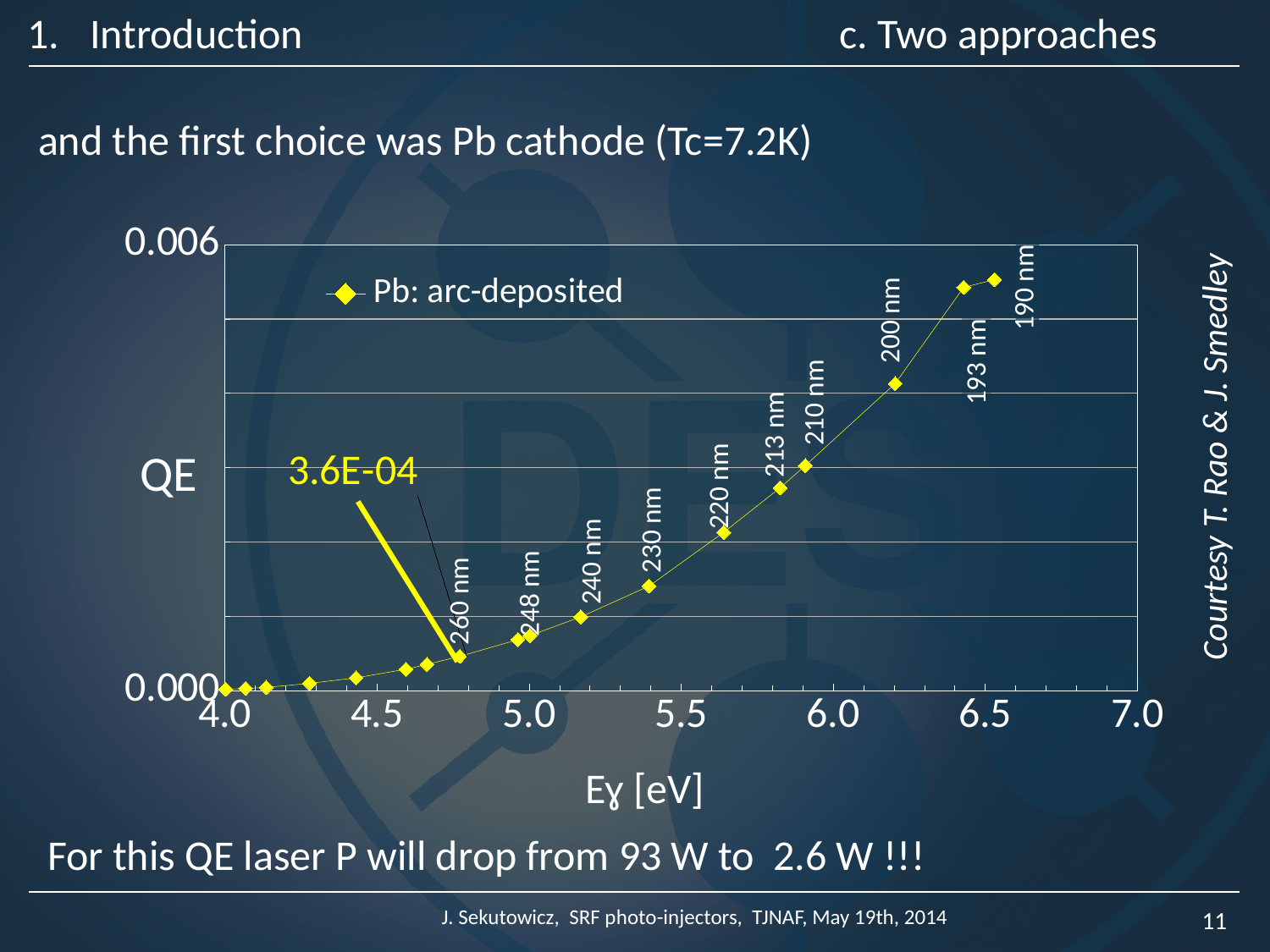
What is the label of the x axis of the chart? Eγ [eV] Which labeled wavelength point has the lowest QE? 260 nm What QE value is annotated for the 260 nm data point? 3.6E-04 Which labeled wavelength point has the highest QE? 190 nm What kind of chart is shown on the slide? line chart with markers How many series does the chart legend list? 1 Which has the larger QE, the 200 nm point or the 220 nm point? 200 nm How many data points on the chart are labeled with a wavelength in nm? 10 Does QE rise or fall as Eγ increases along the x axis? rise What is the name of the series shown in the chart legend? Pb: arc-deposited Is the QE value for the 190 nm point greater or less than 0.006? less Which has the larger QE, the 240 nm point or the 213 nm point? 213 nm